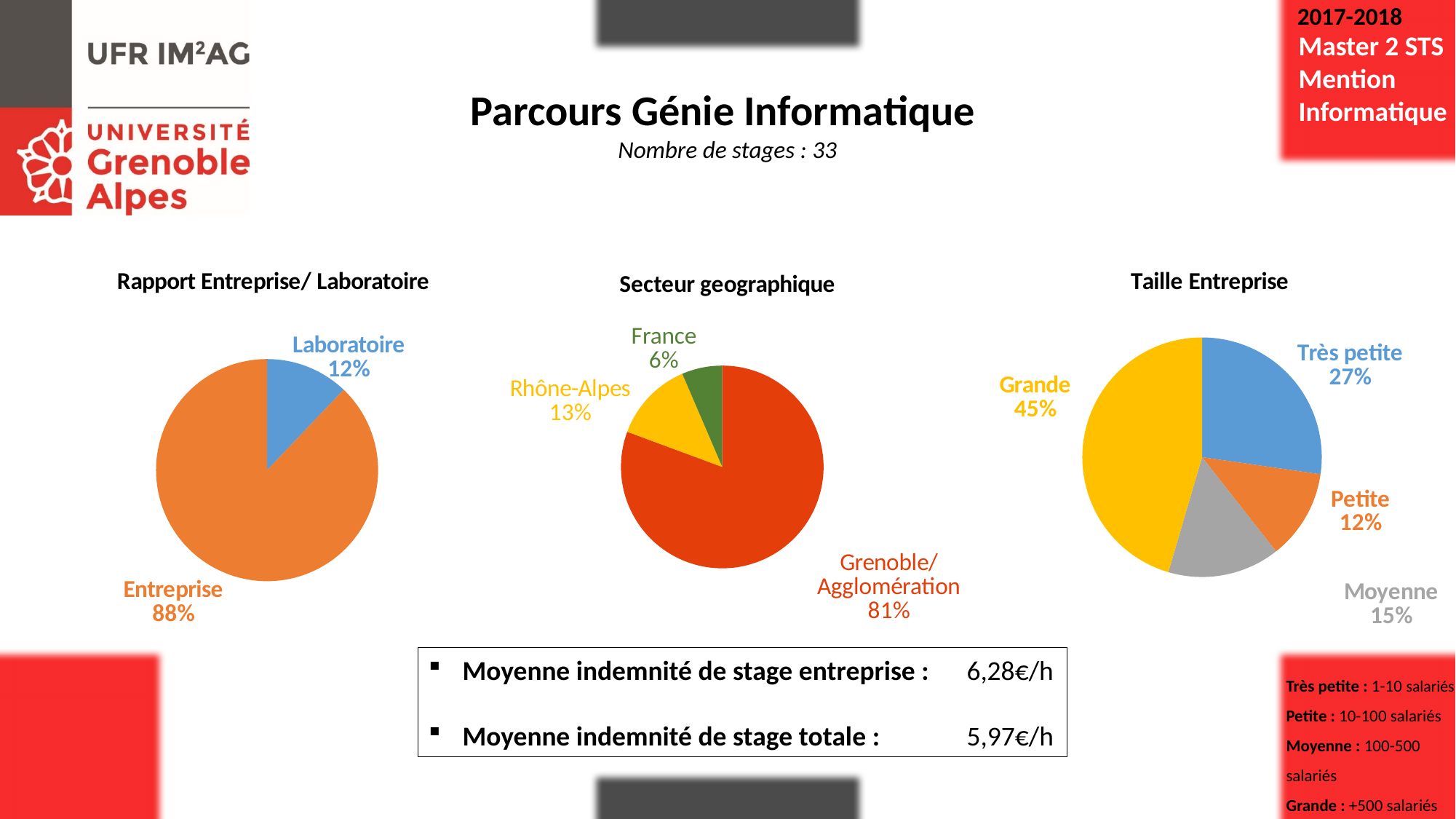
What type of chart is the 'Taille Entreprise' chart? Pie chart In the 'Taille Entreprise' pie chart, which category has the largest share? Grande In the 'Secteur geographique' pie chart, which category has the smallest share? France In the 'Taille Entreprise' pie chart, which category has the smallest share? Petite In the 'Taille Entreprise' pie chart, what share is Grande? 45% In the 'Taille Entreprise' pie chart, which is larger, Très petite or Moyenne? Très petite In the 'Rapport Entreprise/ Laboratoire' pie chart, what share is Laboratoire? 12% In the 'Secteur geographique' pie chart, what share is Grenoble/Agglomération? 81% In the 'Secteur geographique' pie chart, how many categories are shown? 3 In the 'Taille Entreprise' pie chart, what is the difference between the Très petite and Moyenne shares? 12%